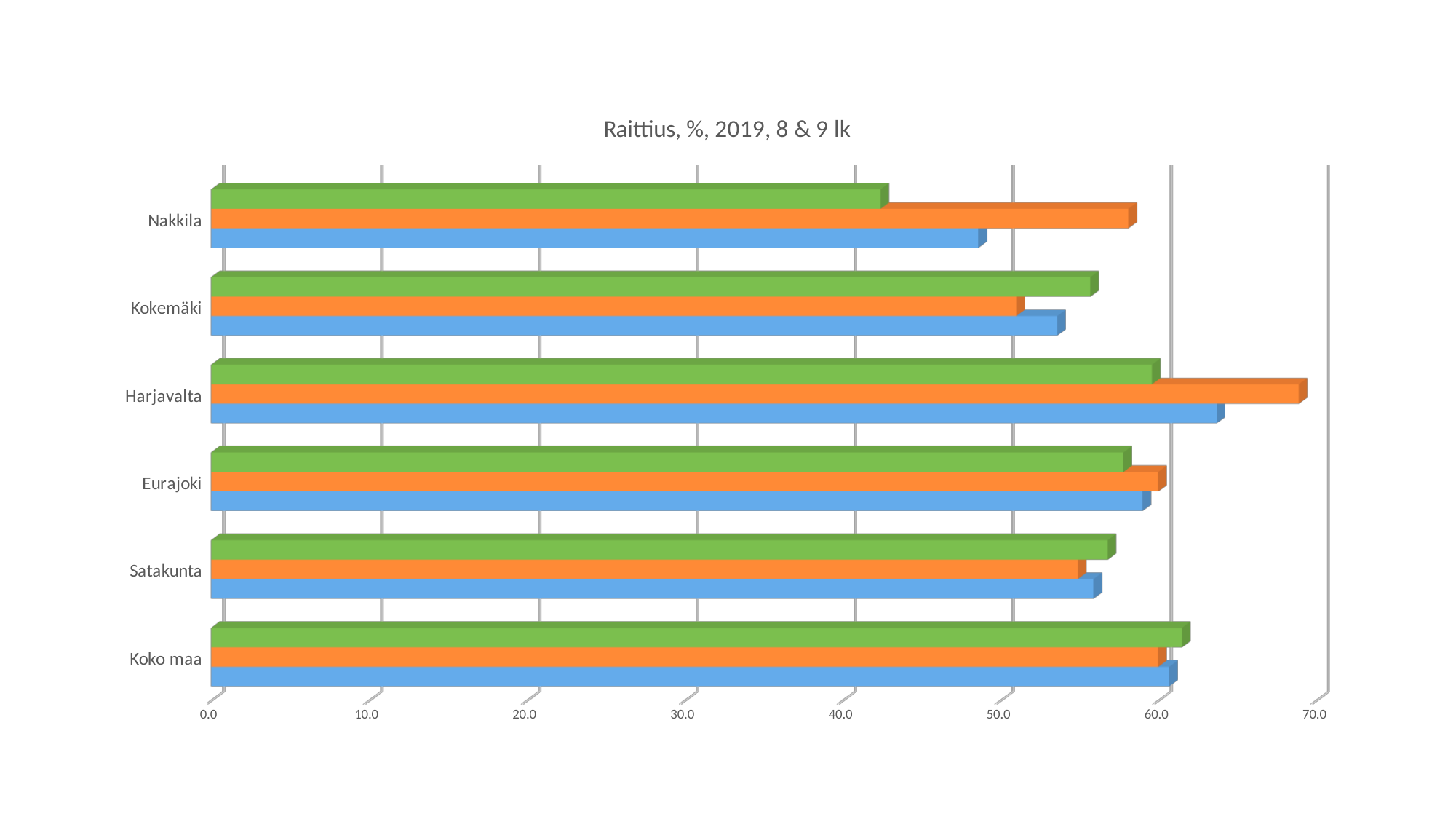
Is the value of the green bar for Nakkila greater or less than 50.0? less Is the value of the blue bar for Harjavalta greater or less than 60.0? greater How many bars are plotted for each category in the chart? 3 Which has the larger orange bar: Harjavalta or Kokemäki? Harjavalta Which category has the shortest blue bar? Nakkila Which category has the shortest green bar? Nakkila How many categories are shown on the vertical axis of the chart? 6 Is the value of the orange bar for Harjavalta greater or less than 60.0? greater For Nakkila, which is larger: the orange bar or the green bar? the orange bar What is the title of the chart? Raittius, %, 2019, 8 & 9 lk Which category has the longest orange bar? Harjavalta What kind of chart is shown on the slide? bar chart